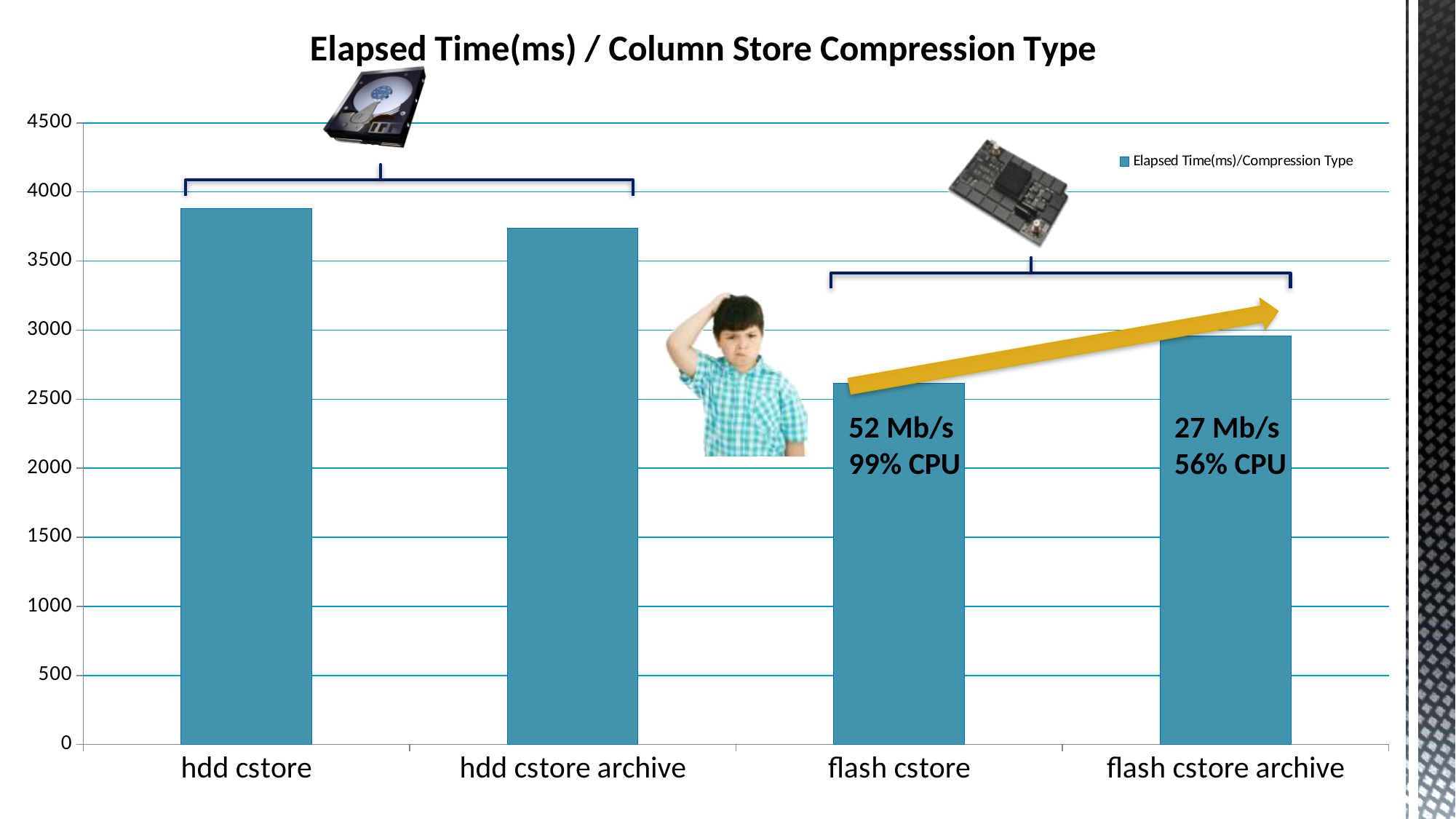
How many categories are plotted along the x axis? 4 Which has a larger elapsed time, hdd cstore archive or flash cstore archive? hdd cstore archive Is the value for hdd cstore greater or less than 3500? greater Which has a larger elapsed time, flash cstore or flash cstore archive? flash cstore archive Which category has the highest elapsed time? hdd cstore What is the legend entry for the plotted series? Elapsed Time(ms)/Compression Type What kind of chart is shown on the slide? bar chart Which category has the lowest elapsed time? flash cstore Is the value for flash cstore archive greater or less than 2500? greater How many series does the legend list? 1 What is the title of the chart? Elapsed Time(ms) / Column Store Compression Type Is the value for flash cstore greater or less than 3000? less